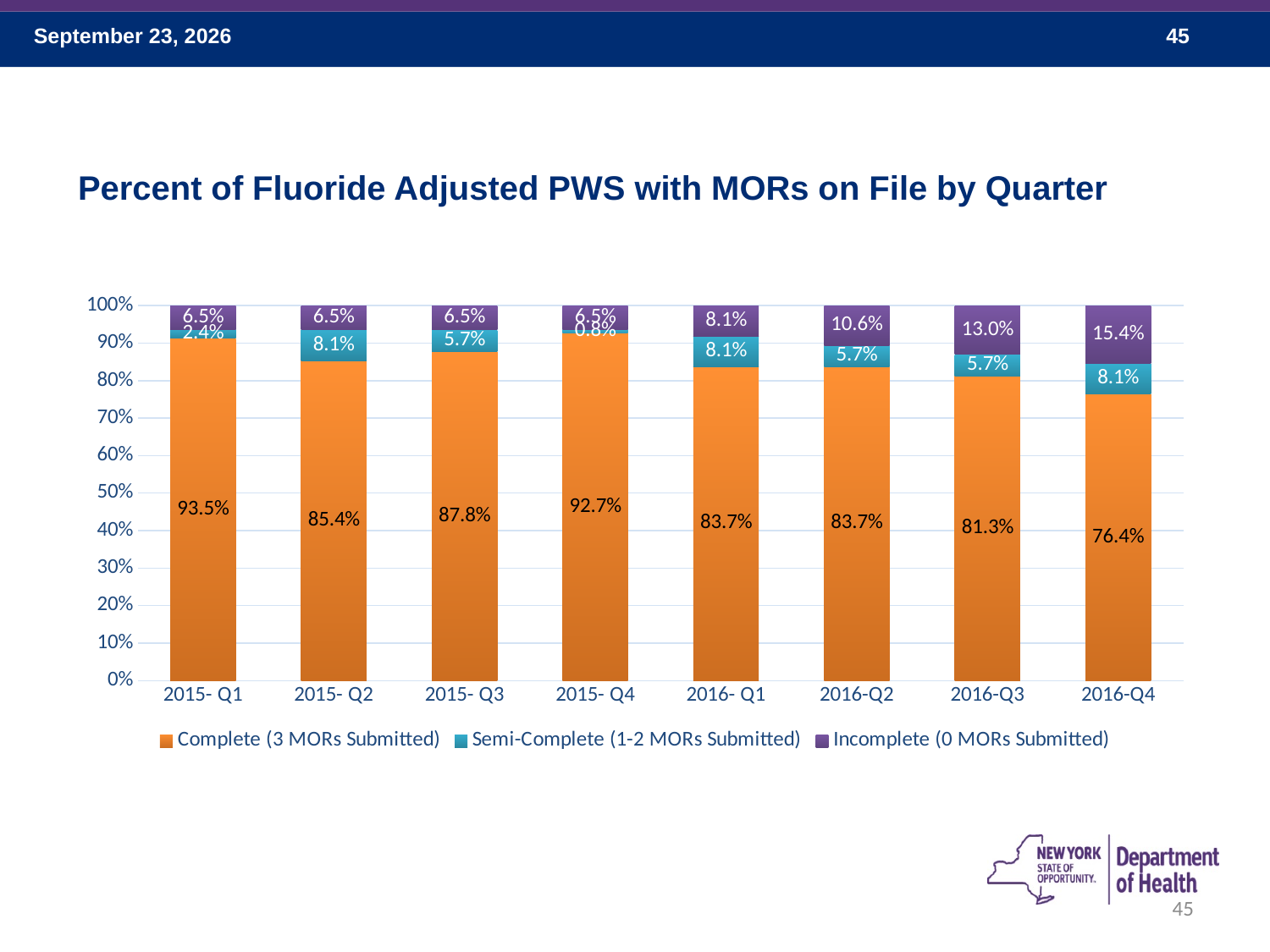
How many series does the legend list? 3 Which quarter has the highest Complete (3 MORs Submitted) value? 2015- Q1 What is the Complete (3 MORs Submitted) value for 2015- Q1? 93.5% Which quarter has the highest Incomplete (0 MORs Submitted) value? 2016-Q4 What type of chart is shown on the slide? stacked bar chart What is the Semi-Complete (1-2 MORs Submitted) value for 2015- Q2? 8.1% Which quarter has the lowest Complete (3 MORs Submitted) value? 2016-Q4 Is the Complete value larger for 2015- Q3 or 2016-Q3? 2015- Q3 What is the Incomplete (0 MORs Submitted) value for 2016-Q4? 15.4% How many quarters are shown on the x axis? 8 What is the difference between the Complete values for 2015- Q1 and 2016-Q4? 17.1% Does the Incomplete (0 MORs Submitted) value rise or fall from 2016- Q1 to 2016-Q4? rise